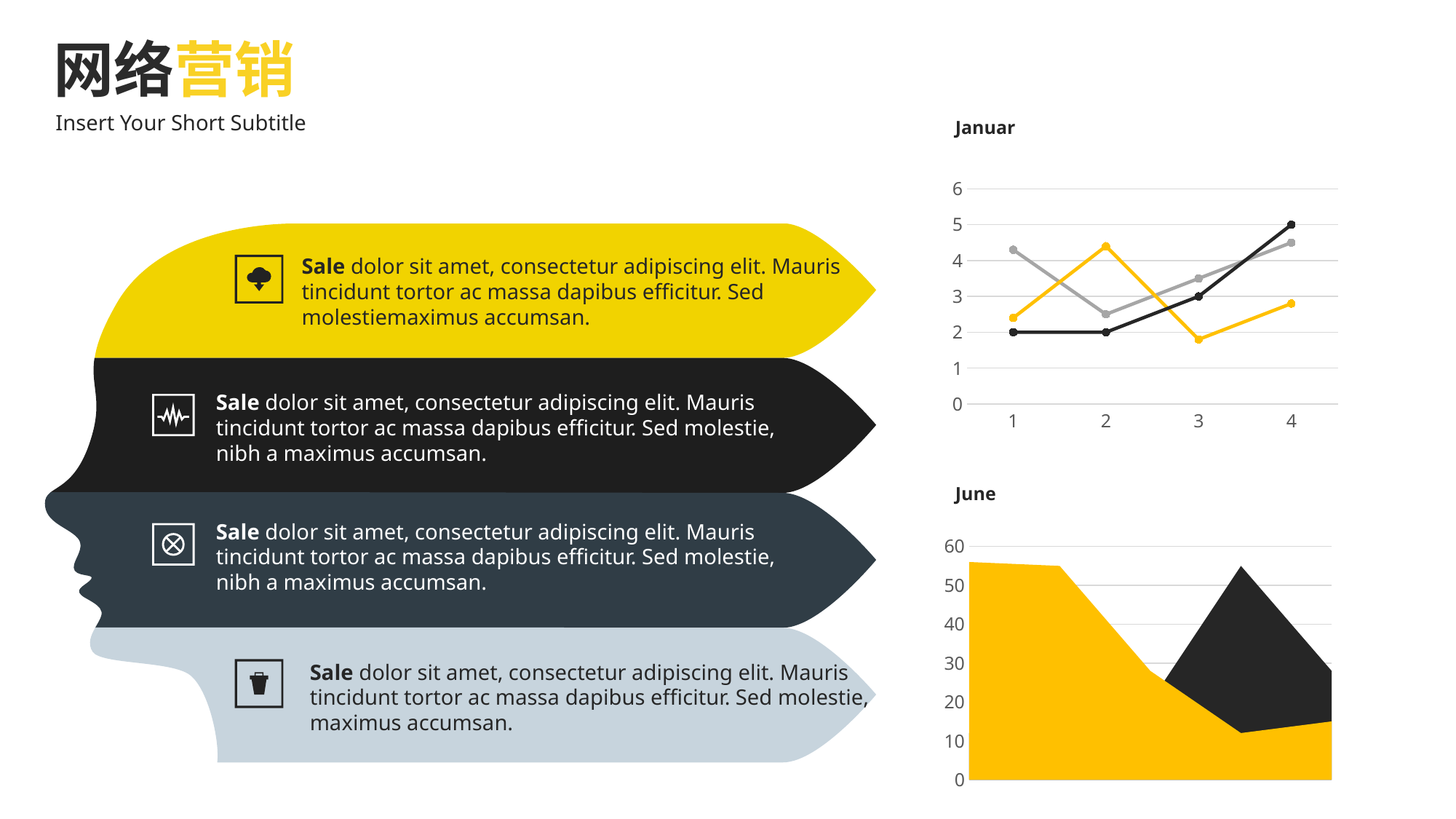
In the "Januar" chart, is the value of the yellow line at x = 2 greater or less than 4? greater In the "Januar" chart, at which x value does the black line reach its highest point? 4 In the "Januar" chart, which line has the highest value at x = 2? the yellow line In the "Januar" chart, what is the value of the black line at x = 3? 3 In the "Januar" chart, what is the value of the black line at x = 4? 5 In the "Januar" chart, what is the value of the black line at x = 1? 2 What kind of chart is the chart titled "Januar"? line chart In the "Januar" chart, is the value of the yellow line at x = 3 greater or less than 2? less In the "Januar" chart, does the black line rise or fall from x = 1 to x = 4? rise In the "June" chart, is the peak of the black area greater or less than 50? greater What kind of chart is the chart titled "June"? area chart In the "Januar" chart, how many points are plotted along the x axis for each line? 4